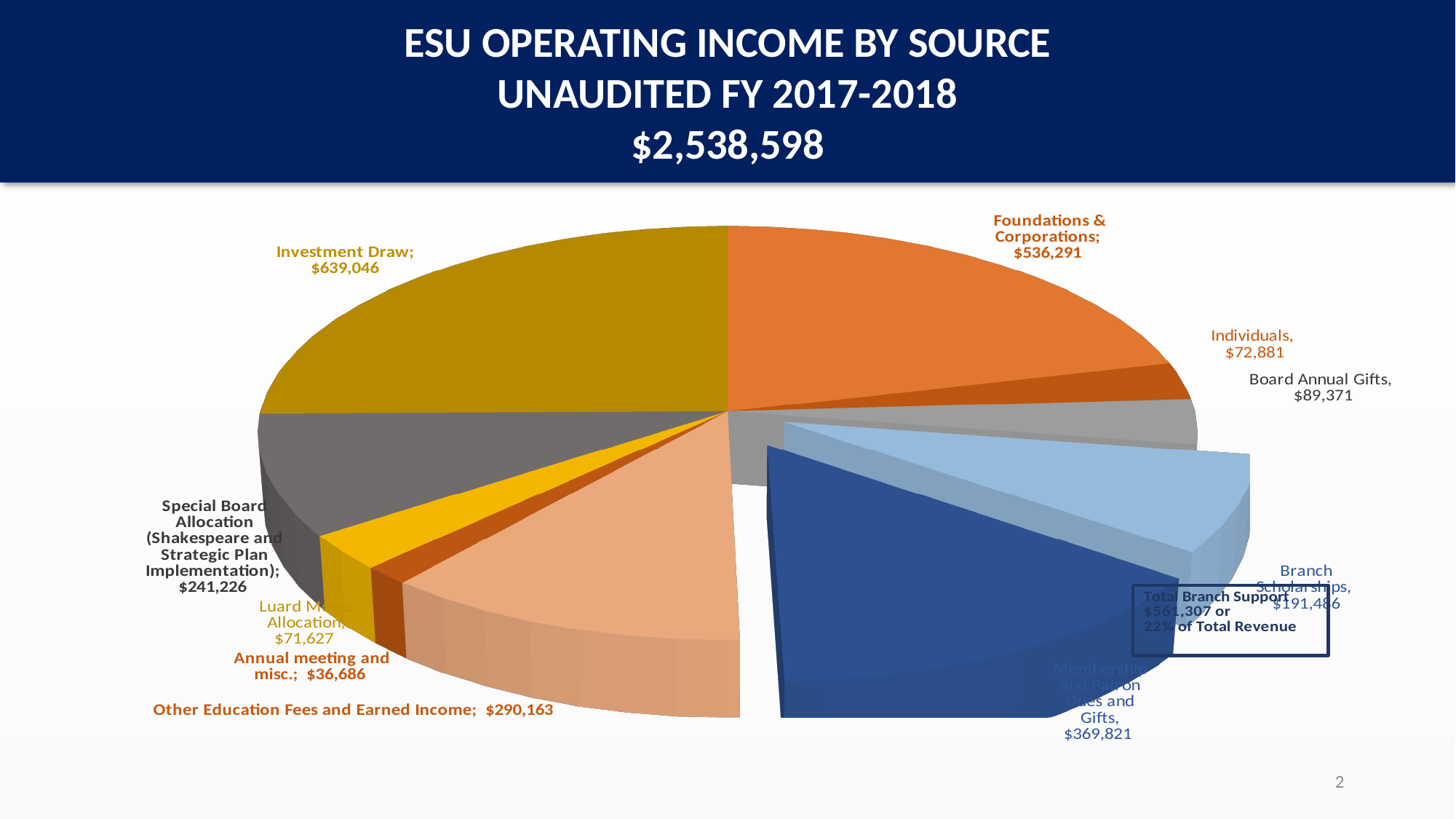
Which source has the lowest value? Annual meeting and misc. How many income sources are shown in the pie chart? 10 What share of total revenue does Total Branch Support represent? 22% What is the value for Membership and Patron Dues and Gifts? $369,821 What is the value for Investment Draw? $639,046 Which source has the highest value? Investment Draw What is the value for Other Education Fees and Earned Income? $290,163 What is the difference between Board Annual Gifts and Individuals? $16,490 What kind of chart is shown on the slide? Pie chart What is the value for Foundations & Corporations? $536,291 What is the difference between Investment Draw and Foundations & Corporations? $102,755 Which is larger, Branch Scholarships or Special Board Allocation (Shakespeare and Strategic Plan Implementation)? Special Board Allocation (Shakespeare and Strategic Plan Implementation)